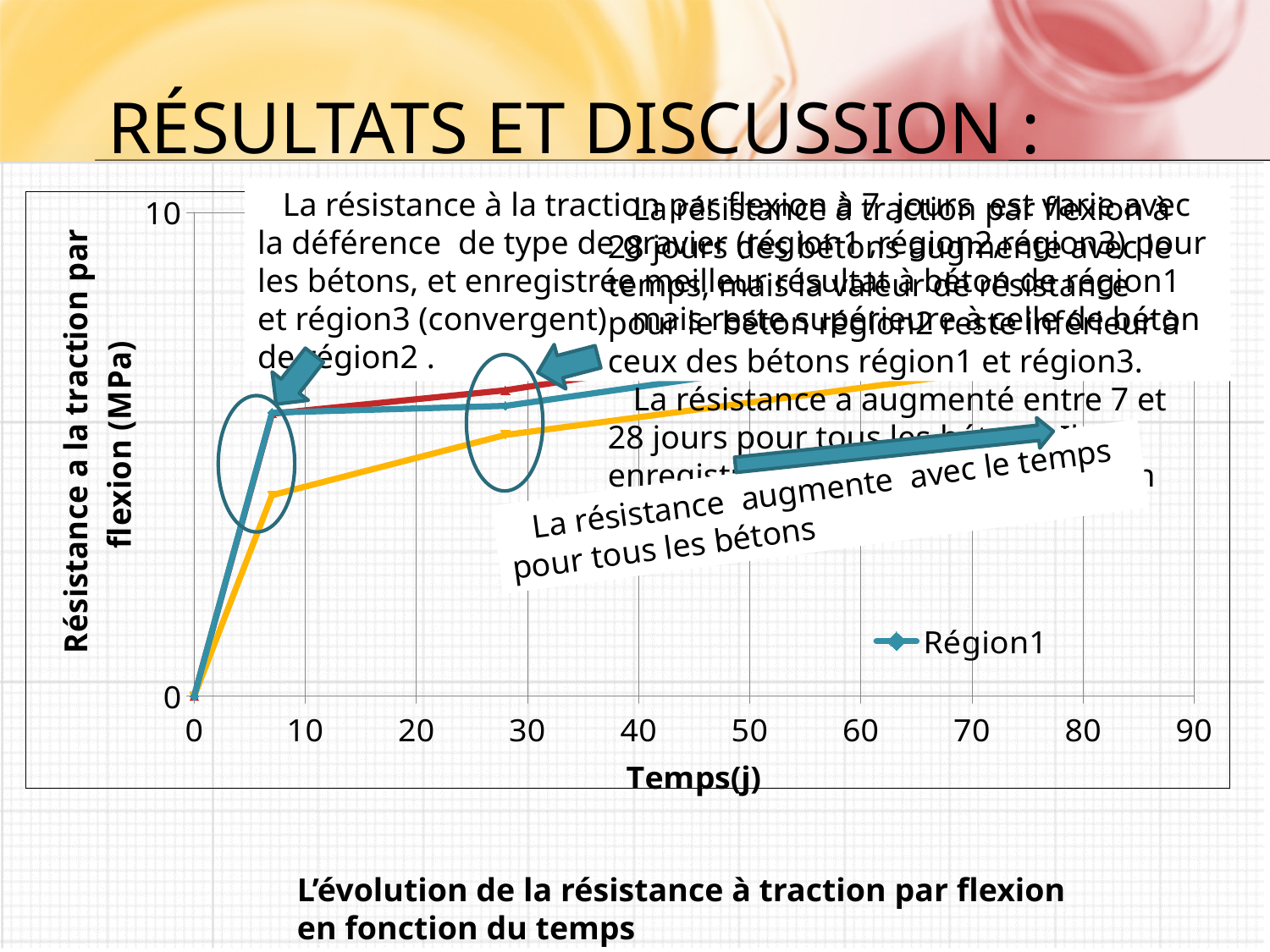
Is the value of the yellow line at 7 days greater or less than 10 MPa? less What is the highest tick value shown on the x axis? 90 At 28 days, which is higher: the Région1 line or the yellow line? Région1 Is the value for Région1 at 28 days greater or less than 10 MPa? less What kind of chart is shown on the slide? line chart Does the Région1 line rise or fall as time increases along the x axis? rise How many lines are plotted on the chart? 3 What is the title of the x axis of the chart? Temps(j) Which series name is readable in the chart legend? Région1